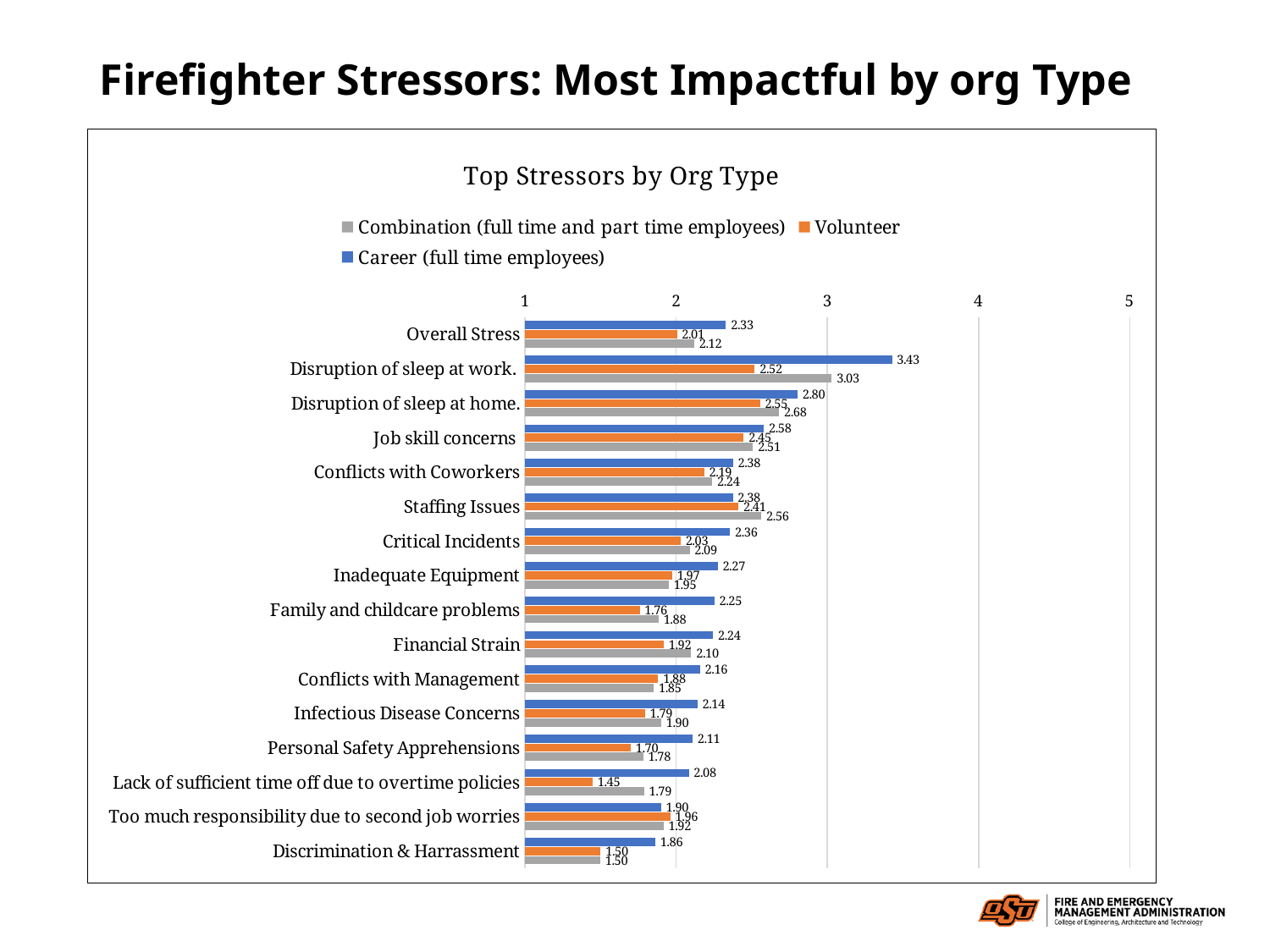
What is the title of the chart? Top Stressors by Org Type What is the Combination (full time and part time employees) value for Staffing Issues? 2.56 What is the Volunteer value for Lack of sufficient time off due to overtime policies? 1.45 How many stressor categories are shown on the chart? 16 Which stressor has the highest Career (full time employees) value? Disruption of sleep at work. For Staffing Issues, which is larger: the Combination value or the Career value? Combination (full time and part time employees) What is the difference between the Career and Volunteer values for Disruption of sleep at work.? 0.91 What kind of chart is shown on the slide? Bar chart Is the Combination value for Disruption of sleep at work. greater or less than 3? greater How many series does the legend list? 3 Which stressor has the lowest Volunteer value? Lack of sufficient time off due to overtime policies What is the Career (full time employees) value for Disruption of sleep at work.? 3.43